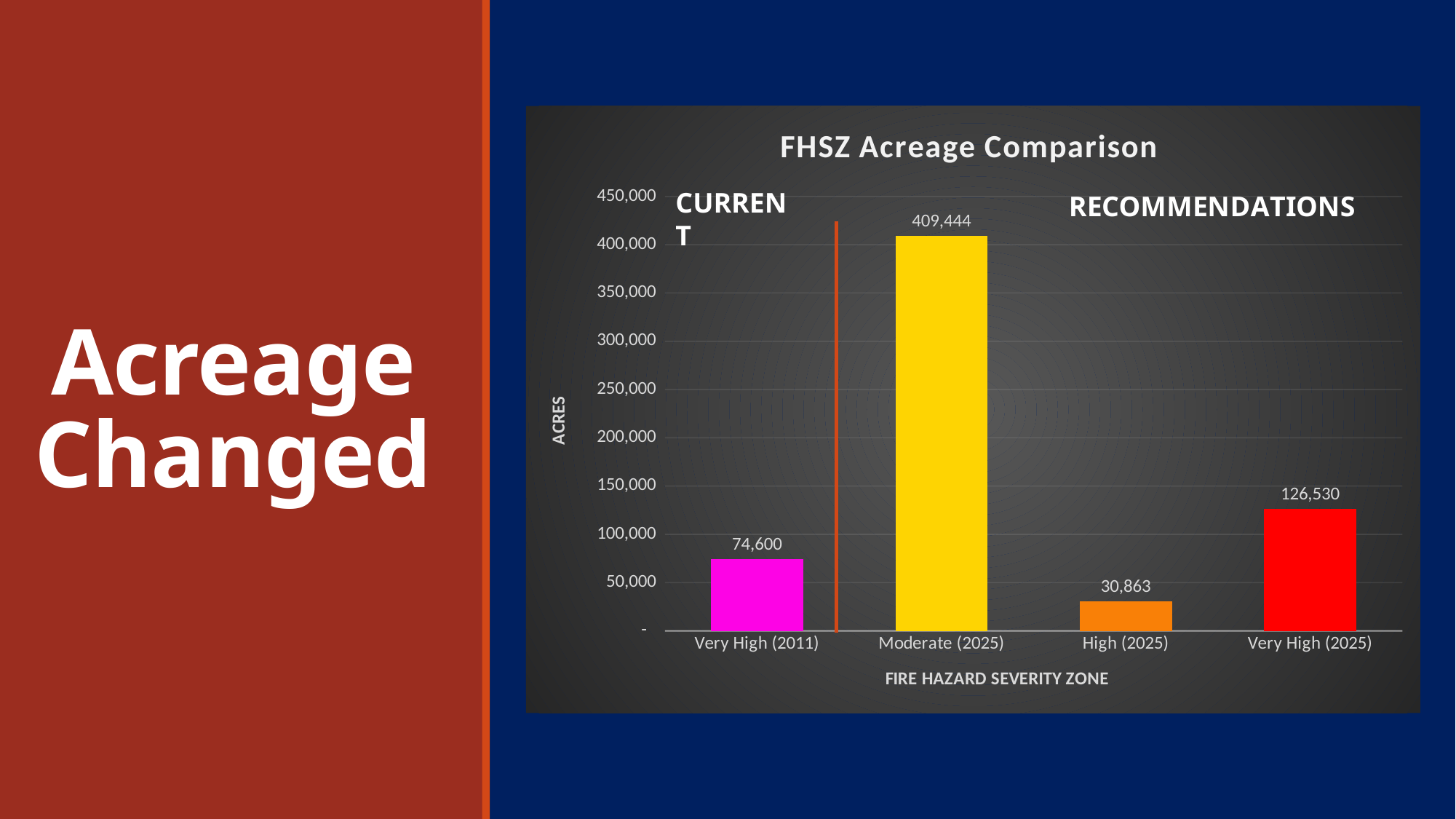
Which category has the lowest value? High (2025) What is the value for Very High (2025)? 126,530 What is the difference between Very High (2025) and Very High (2011)? 51,930 How many categories are shown on the x axis? 4 What is the title of the chart? FHSZ Acreage Comparison Which is larger, Very High (2011) or High (2025)? Very High (2011) What kind of chart is shown? bar chart What is the value for Very High (2011)? 74,600 What is the value for Moderate (2025)? 409,444 Which category has the highest value? Moderate (2025) Is the value for Very High (2025) greater or less than 100,000? greater What is the value for High (2025)? 30,863